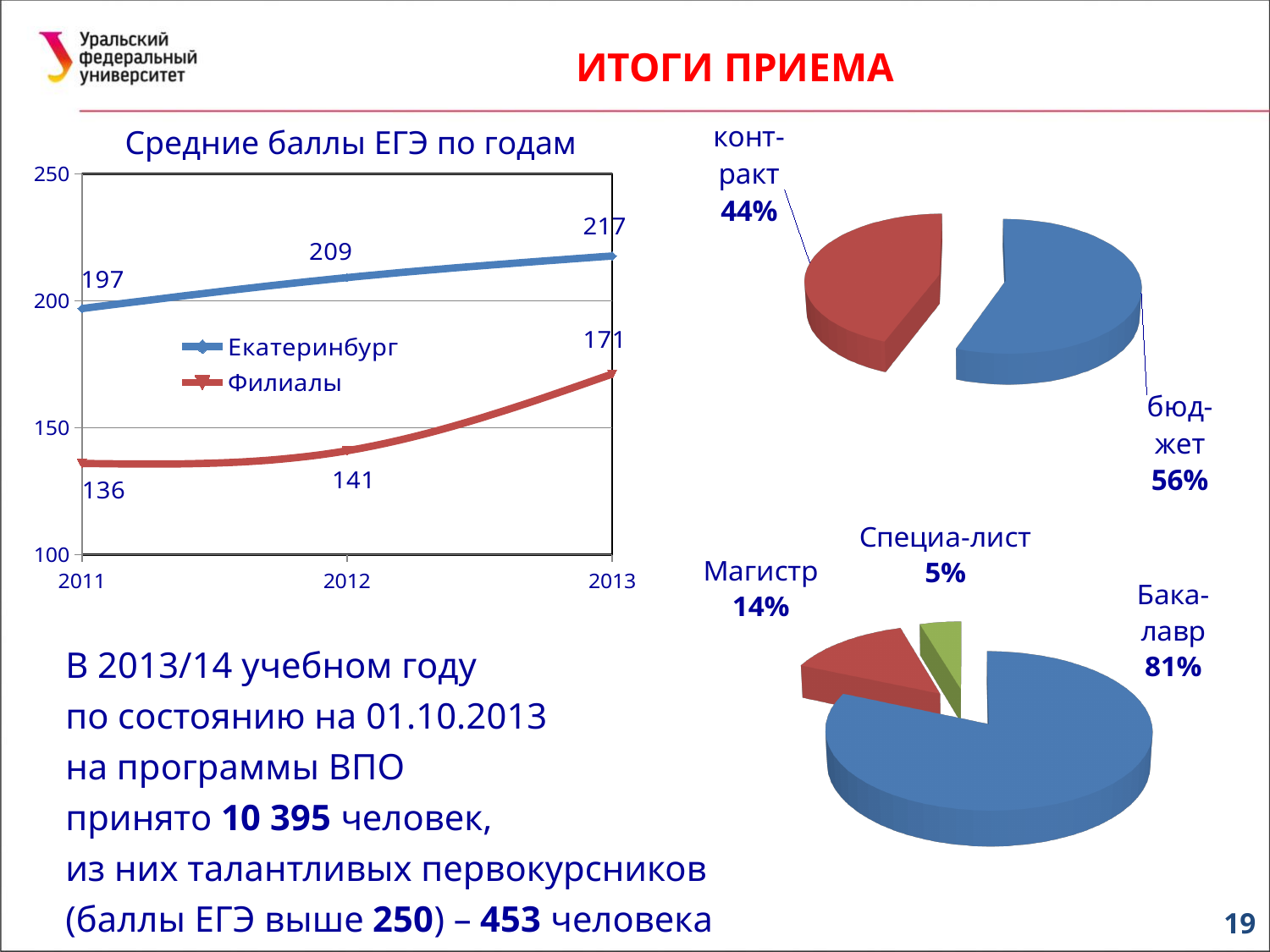
In the chart 'Средние баллы ЕГЭ по годам', do the values for Филиалы rise or fall from 2011 to 2013? rise In the top-right pie chart, what share is бюджет? 56% In the chart 'Средние баллы ЕГЭ по годам', what is the difference between Екатеринбург and Филиалы in 2012? 68 In the chart 'Средние баллы ЕГЭ по годам', which series has the higher value in 2011, Екатеринбург or Филиалы? Екатеринбург In the bottom-right pie chart, which category has the smallest share? Специалист In the chart 'Средние баллы ЕГЭ по годам', what is the value for Филиалы in 2011? 136 What kind of chart is 'Средние баллы ЕГЭ по годам'? line chart In the top-right pie chart, which slice is larger, контракт or бюджет? бюджет How many series does the legend of the chart 'Средние баллы ЕГЭ по годам' list? 2 In the bottom-right pie chart, what share is Магистр? 14% In the chart 'Средние баллы ЕГЭ по годам', what is the value for Екатеринбург in 2013? 217 In the chart 'Средние баллы ЕГЭ по годам', by how much did the Филиалы value increase from 2012 to 2013? 30